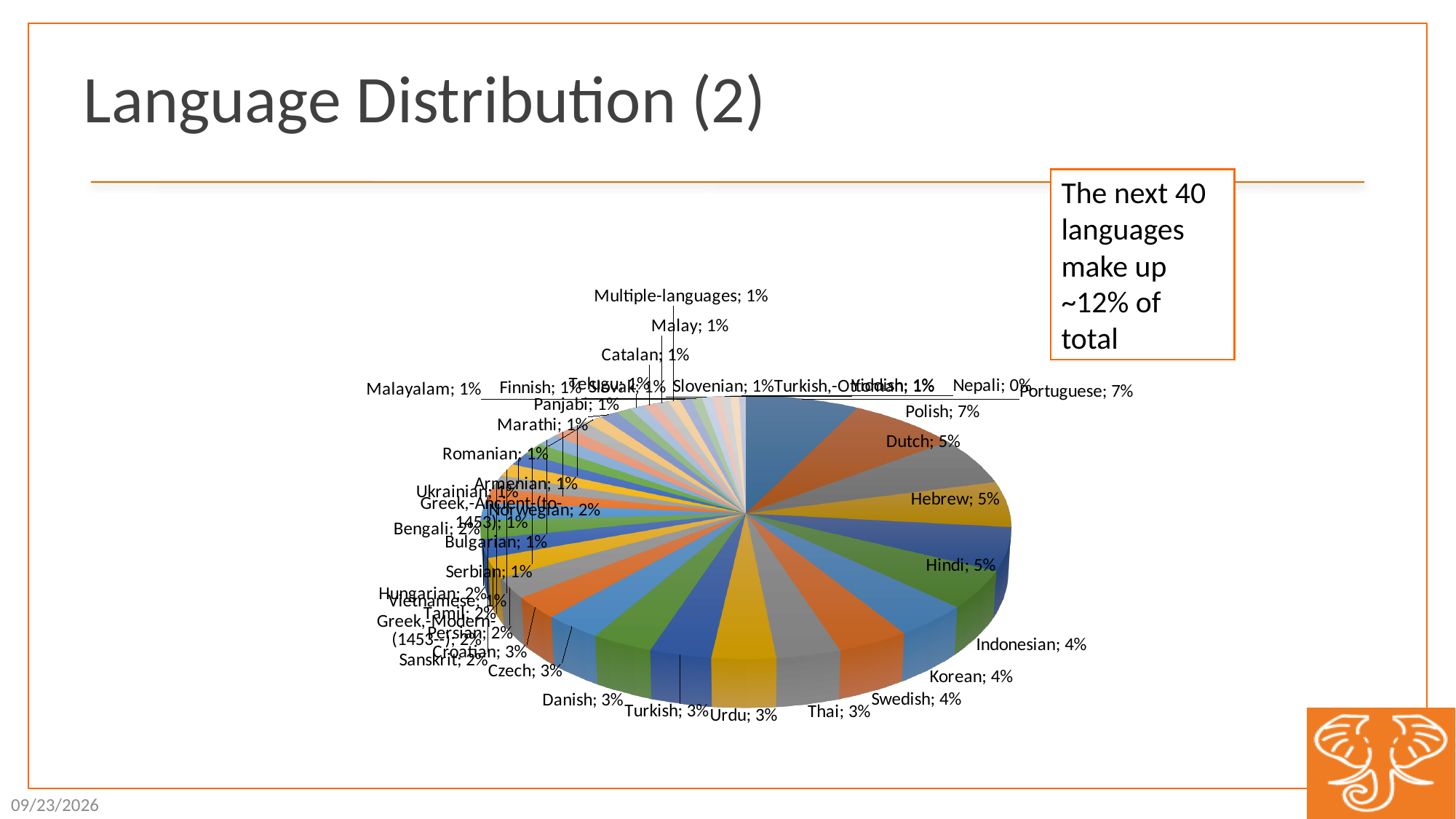
What percentage does the Hindi slice represent? 5% What is the difference in percentage points between the Portuguese slice and the Hindi slice? 2% Which language has the smallest share in the pie chart? Nepali What percentage does the Nepali slice represent? 0% What percentage does the Korean slice represent? 4% Which slice is larger, Dutch or Korean? Dutch What kind of chart is shown on the slide? pie chart Which slice is larger, Polish or Thai? Polish What percentage does the Czech slice represent? 3% What percentage does the Portuguese slice represent? 7% What is the title of the slide containing the pie chart? Language Distribution (2) According to the text box next to the chart, what share of the total do the next 40 languages make up? ~12%